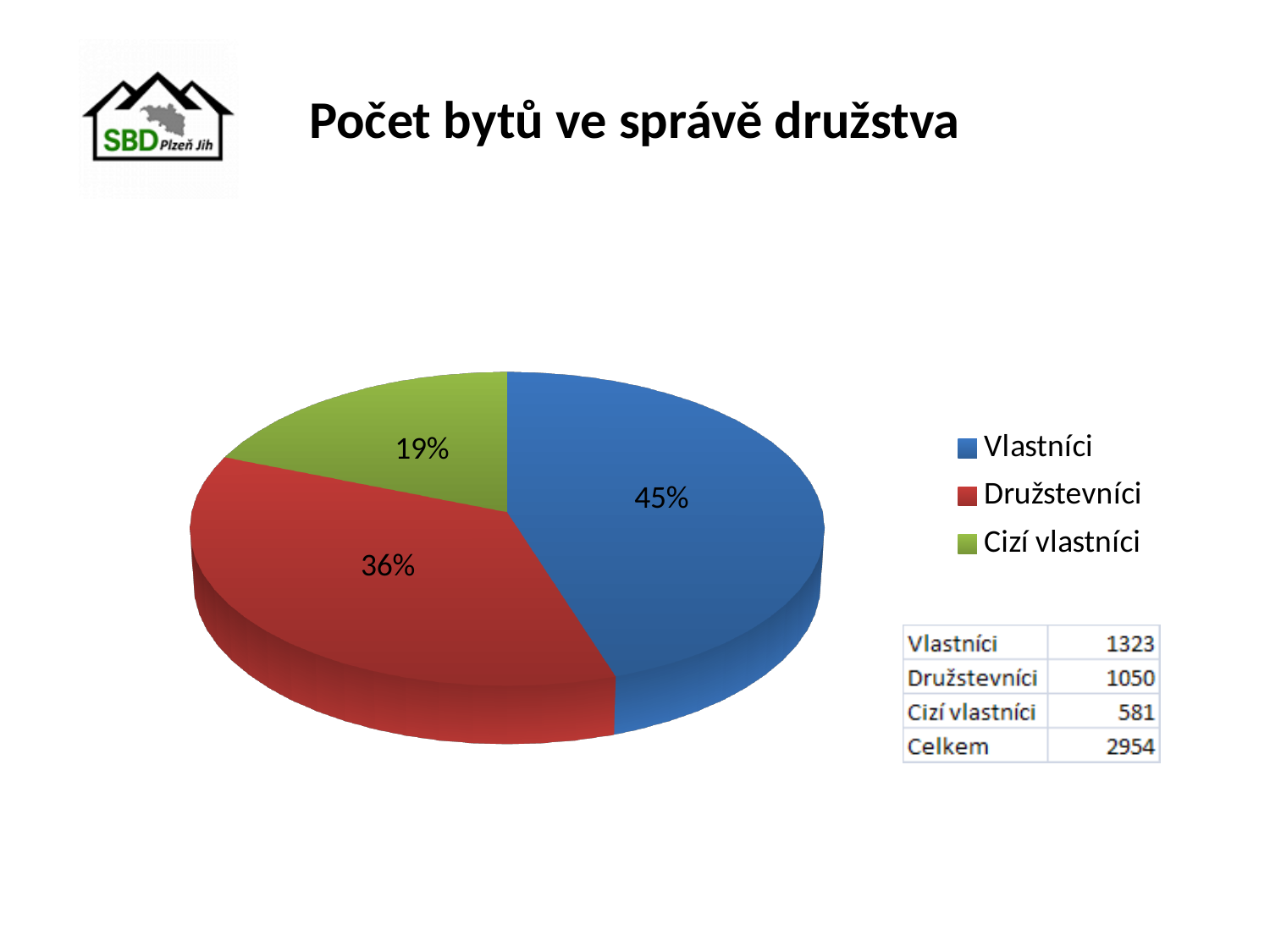
What is the title of the slide containing the chart? Počet bytů ve správě družstva Which category has the smallest slice of the pie? Cizí vlastníci What is the difference in percentage points between the Vlastníci and Družstevníci slices? 9% Which category has the largest slice of the pie? Vlastníci What kind of chart is shown on the slide? Pie chart What share of the pie does Vlastníci represent? 45% How many slices does the pie chart have? 3 Which slice is larger, Družstevníci or Cizí vlastníci? Družstevníci What share of the pie does Cizí vlastníci represent? 19% What share of the pie does Družstevníci represent? 36% How many entries does the legend list? 3 What colour is the Družstevníci slice in the pie chart? Red